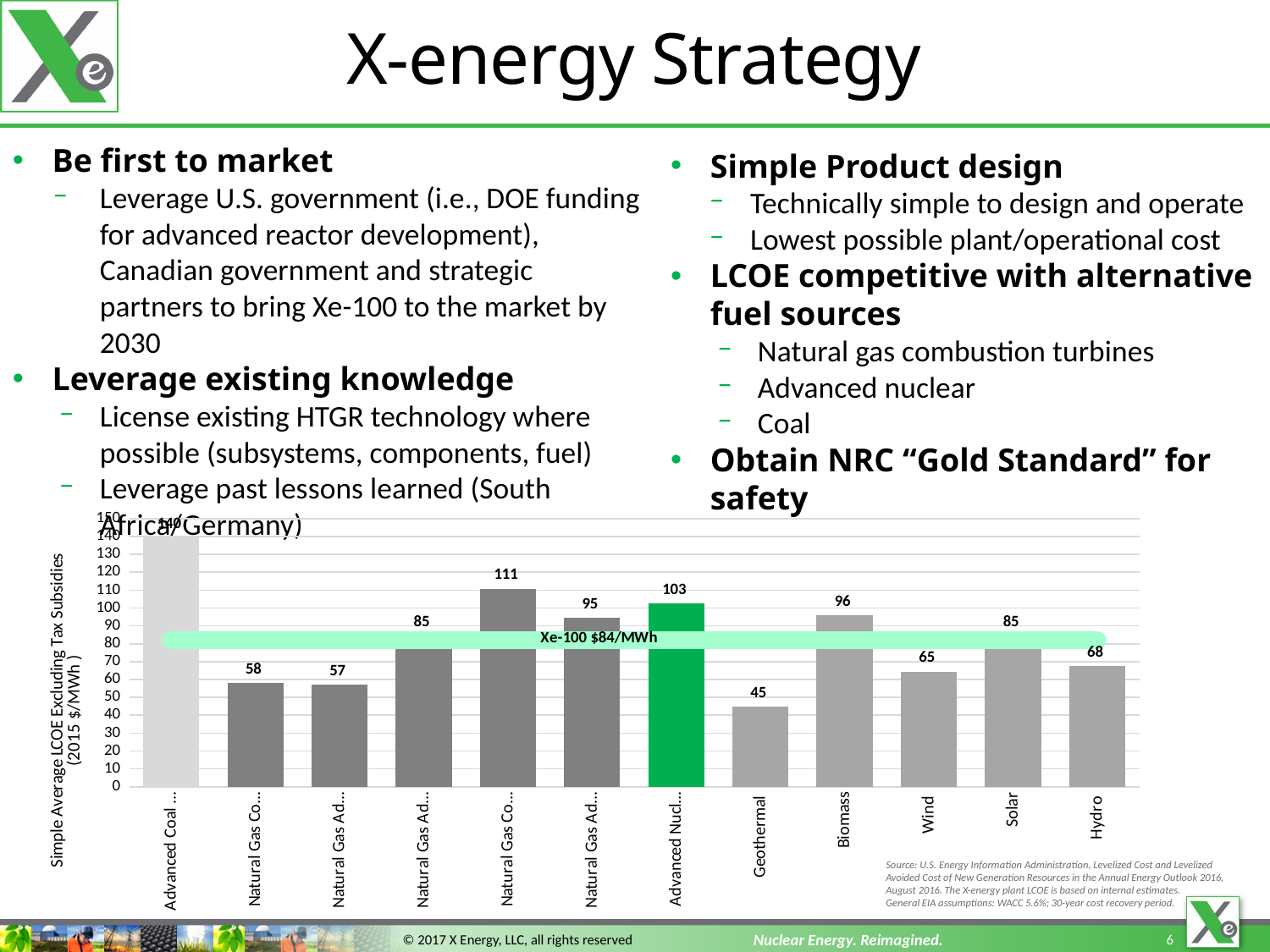
What is the value for Geothermal? 45 What is the difference between the values for Biomass and Wind? 31 What LCOE value is shown for the Xe-100 reference line? $84/MWh What is the value for Biomass? 96 What kind of chart is shown? bar chart Which is larger, the value for Solar or the value for Hydro? Solar What is the value for Wind? 65 Is the value for Advanced Coal greater or less than 130? greater What is the value for Hydro? 68 How many categories are shown on the x axis? 12 Which category has the lowest value? Geothermal What is the value for Solar? 85